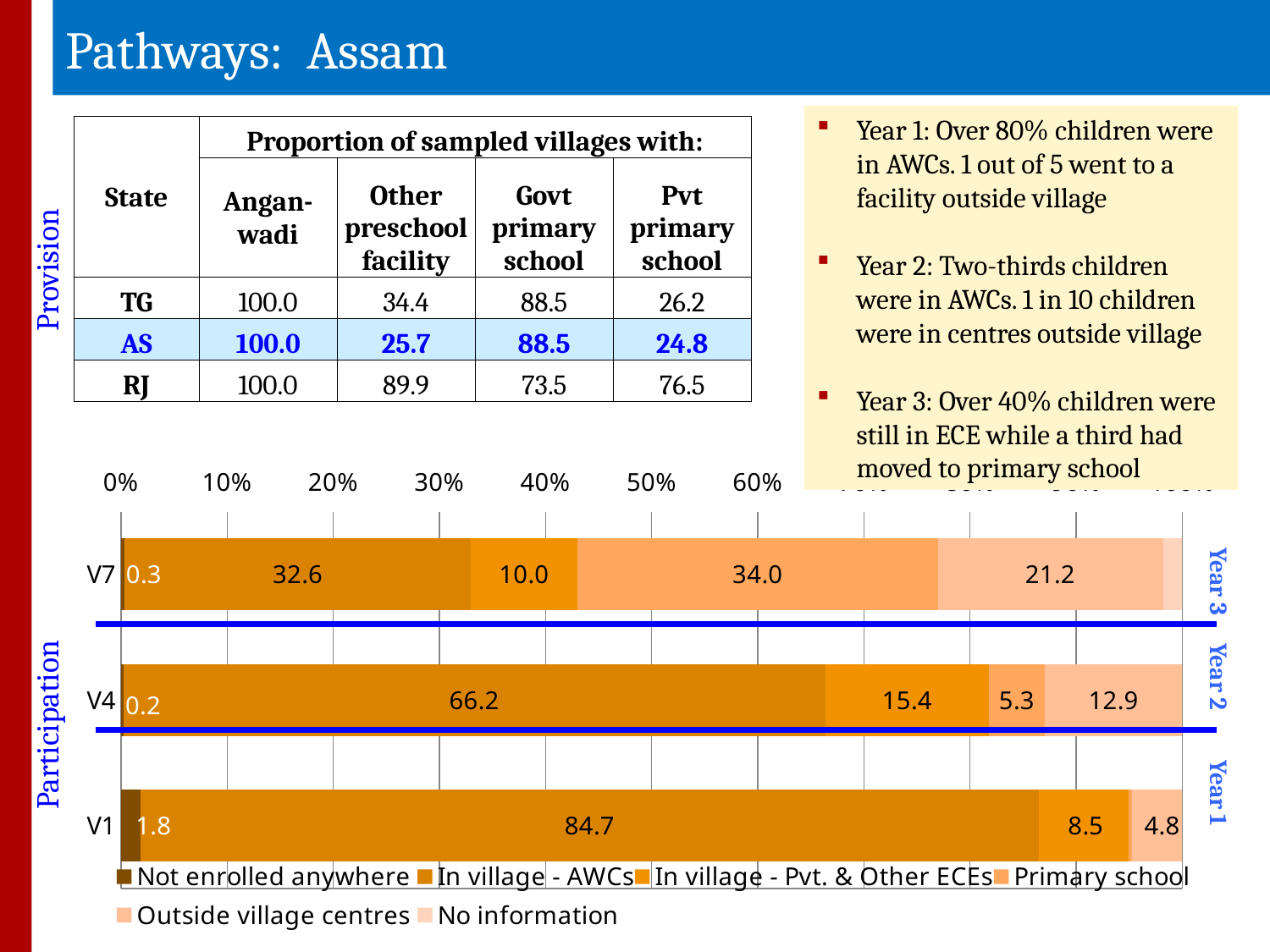
What is the value for 'Primary school' in the V7 bar? 34.0 How many series does the chart's legend list? 6 What is the value for 'In village - AWCs' in the V1 bar? 84.7 What kind of chart is shown on the slide? Stacked bar chart What is the value for 'In village - AWCs' in the V4 bar? 66.2 Which year label is shown next to the V1 bar? Year 1 Does the 'In village - AWCs' value rise or fall from V1 to V7? Fall What is the difference between the 'In village - AWCs' values for V1 and V4? 18.5 Which bar has the highest value for 'In village - AWCs'? V1 How many categories (bars) does the chart show? 3 What is the value for 'Not enrolled anywhere' in the V1 bar? 1.8 What is the value for 'In village - AWCs' in the V7 bar? 32.6